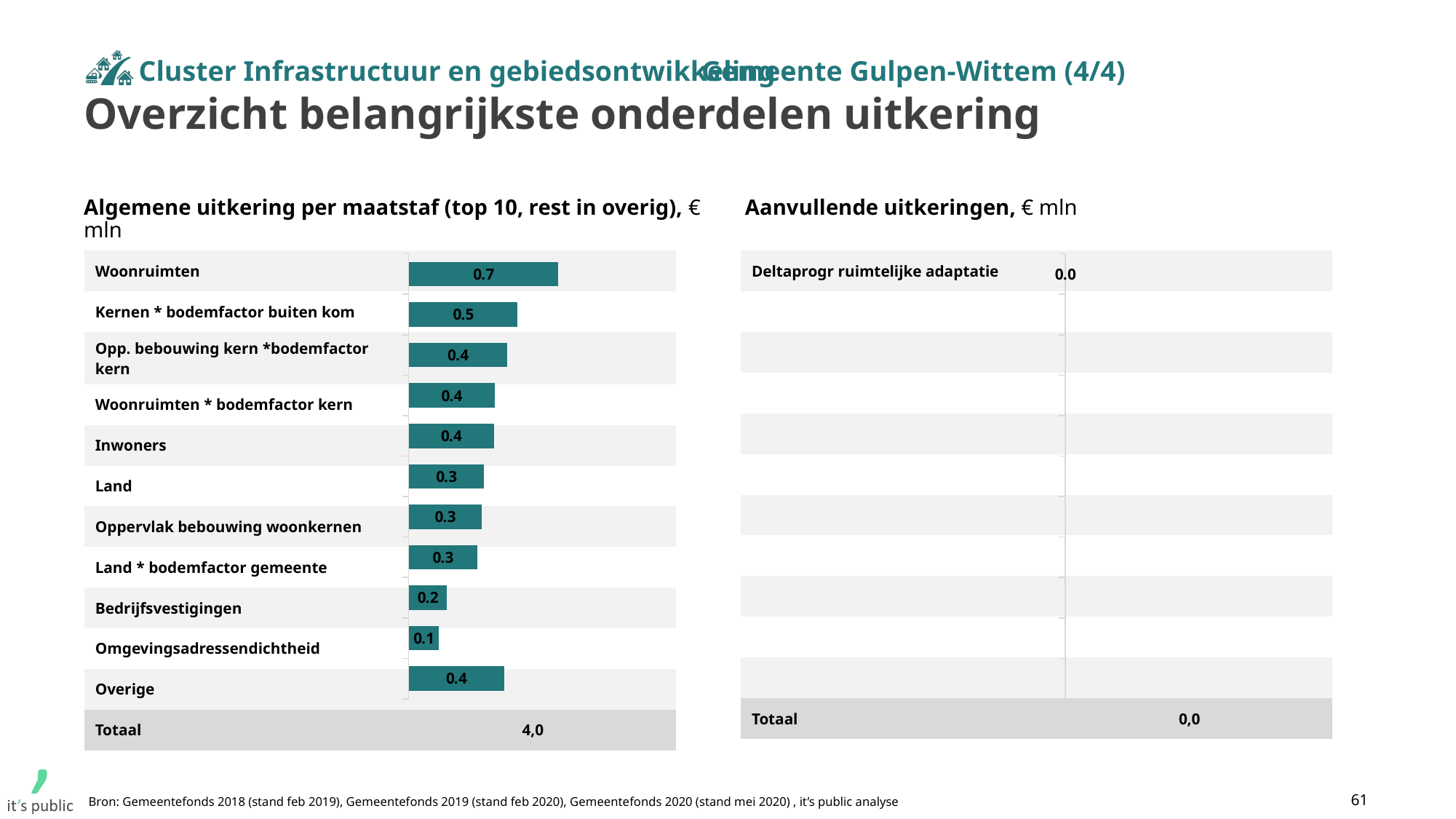
In the 'Algemene uitkering per maatstaf' chart, which category has the lowest value? Omgevingsadressendichtheid In the 'Algemene uitkering per maatstaf' chart, what is the value for Kernen * bodemfactor buiten kom? 0.5 In the 'Algemene uitkering per maatstaf' chart, which is larger: Land or Bedrijfsvestigingen? Land In the 'Algemene uitkering per maatstaf' chart, what is the difference between Woonruimten and Kernen * bodemfactor buiten kom? 0.2 How many categories (bars) are shown in the 'Algemene uitkering per maatstaf' chart? 11 What type of chart is the 'Algemene uitkering per maatstaf' chart? Bar chart In the 'Algemene uitkering per maatstaf' chart, what is the value for Bedrijfsvestigingen? 0.2 In the 'Algemene uitkering per maatstaf' chart, what is the value for Woonruimten? 0.7 In the 'Algemene uitkering per maatstaf' chart, which category has the highest value? Woonruimten In the 'Algemene uitkering per maatstaf' chart, what is the value for Omgevingsadressendichtheid? 0.1 In the 'Aanvullende uitkeringen' chart, what is the value for Deltaprogr ruimtelijke adaptatie? 0.0 What total is shown at the bottom of the 'Algemene uitkering per maatstaf' chart? 4,0